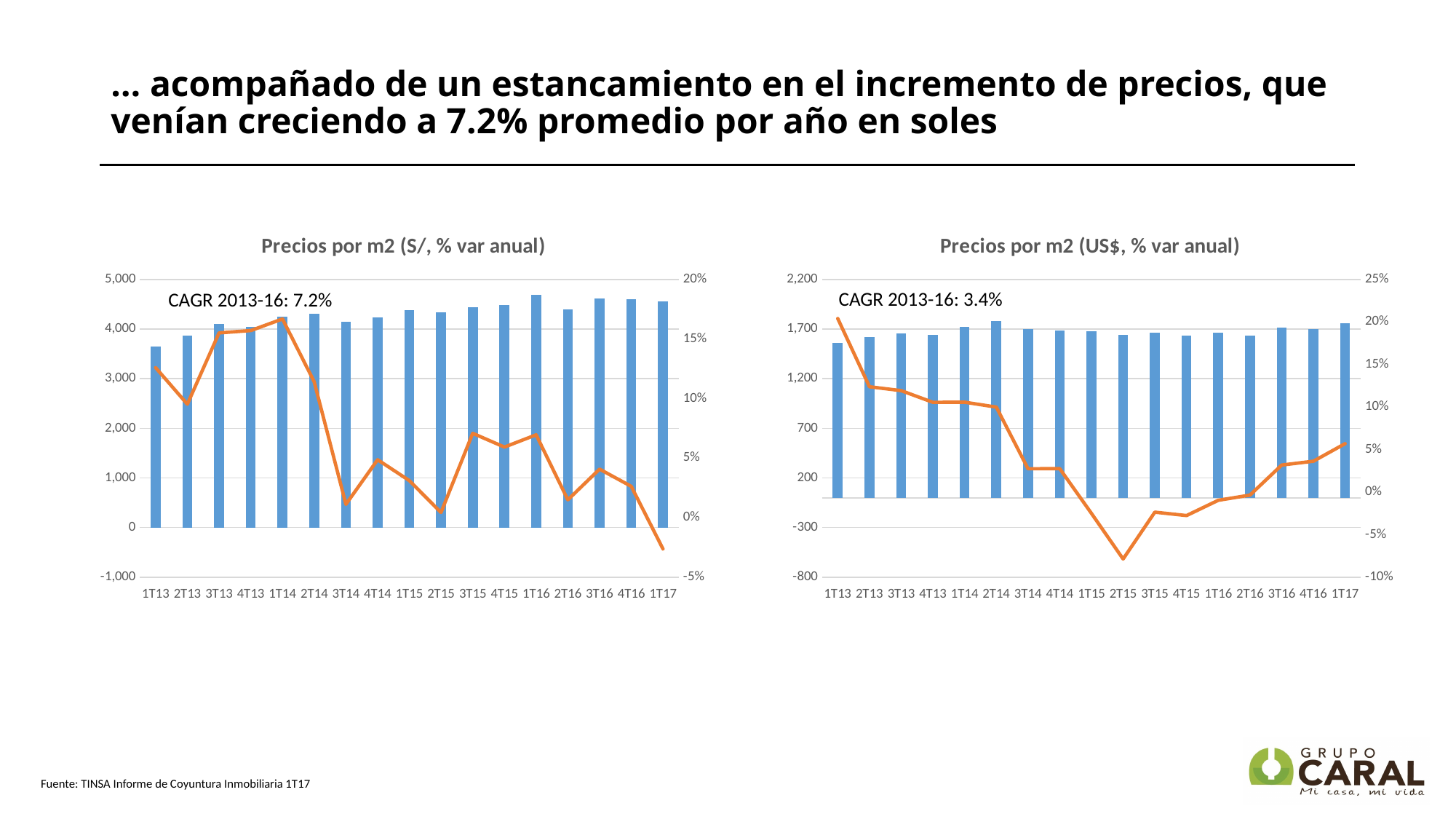
In the right chart 'Precios por m2 (US$, % var anual)', is the bar for 1T13 greater or less than 1,700? less In the left chart 'Precios por m2 (S/, % var anual)', which quarter has the lowest line value (% var anual)? 1T17 In the right chart 'Precios por m2 (US$, % var anual)', which quarter has the lowest bar? 1T13 In the left chart 'Precios por m2 (S/, % var anual)', is the line value (% var anual) for 1T17 greater or less than 0%? less In the right chart 'Precios por m2 (US$, % var anual)', is the line value (% var anual) for 1T13 greater or less than 15%? greater In the left chart 'Precios por m2 (S/, % var anual)', which quarter has the tallest bar? 1T16 In the left chart 'Precios por m2 (S/, % var anual)', which quarter has the lowest bar? 1T13 How many quarters are shown on the x axis of the right chart, 'Precios por m2 (US$, % var anual)'? 17 What kind of chart is the left chart, 'Precios por m2 (S/, % var anual)'? A combined bar and line chart What CAGR for 2013-16 is annotated on the right chart 'Precios por m2 (US$, % var anual)'? 3.4%